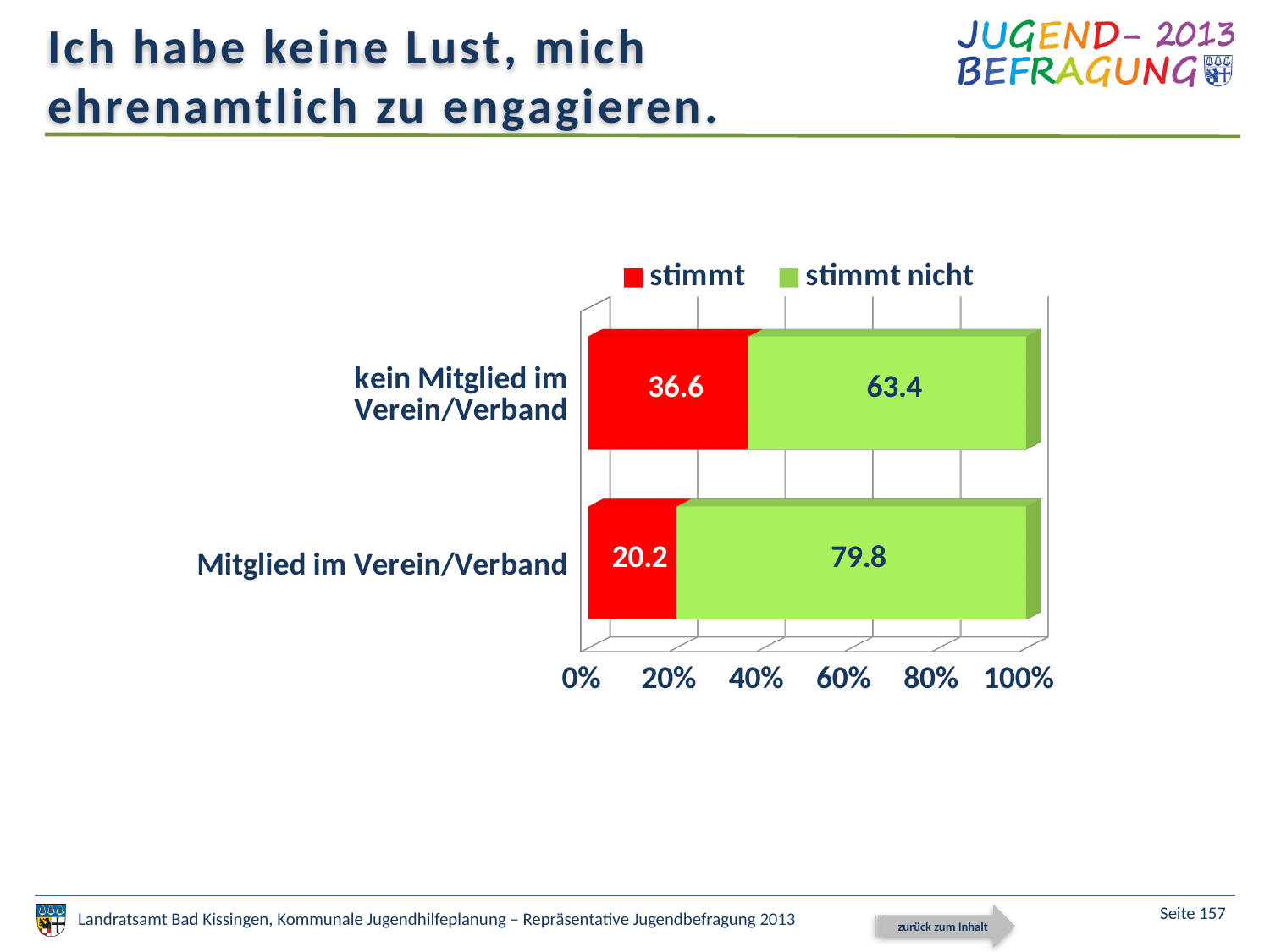
Which category has the lower "stimmt nicht" value? kein Mitglied im Verein/Verband How many series does the legend list? 2 What is the value for "stimmt" for "Mitglied im Verein/Verband"? 20.2 Is the "stimmt" value for "Mitglied im Verein/Verband" larger or smaller than the "stimmt" value for "kein Mitglied im Verein/Verband"? smaller How many categories are shown on the chart? 2 What colour represents the "stimmt nicht" series? green Which category has the higher "stimmt" value? kein Mitglied im Verein/Verband What is the difference between the "stimmt" values for "kein Mitglied im Verein/Verband" and "Mitglied im Verein/Verband"? 16.4 What is the value for "stimmt nicht" for "Mitglied im Verein/Verband"? 79.8 What kind of chart is shown on the slide? stacked bar chart What is the value for "stimmt" for "kein Mitglied im Verein/Verband"? 36.6 What is the value for "stimmt nicht" for "kein Mitglied im Verein/Verband"? 63.4